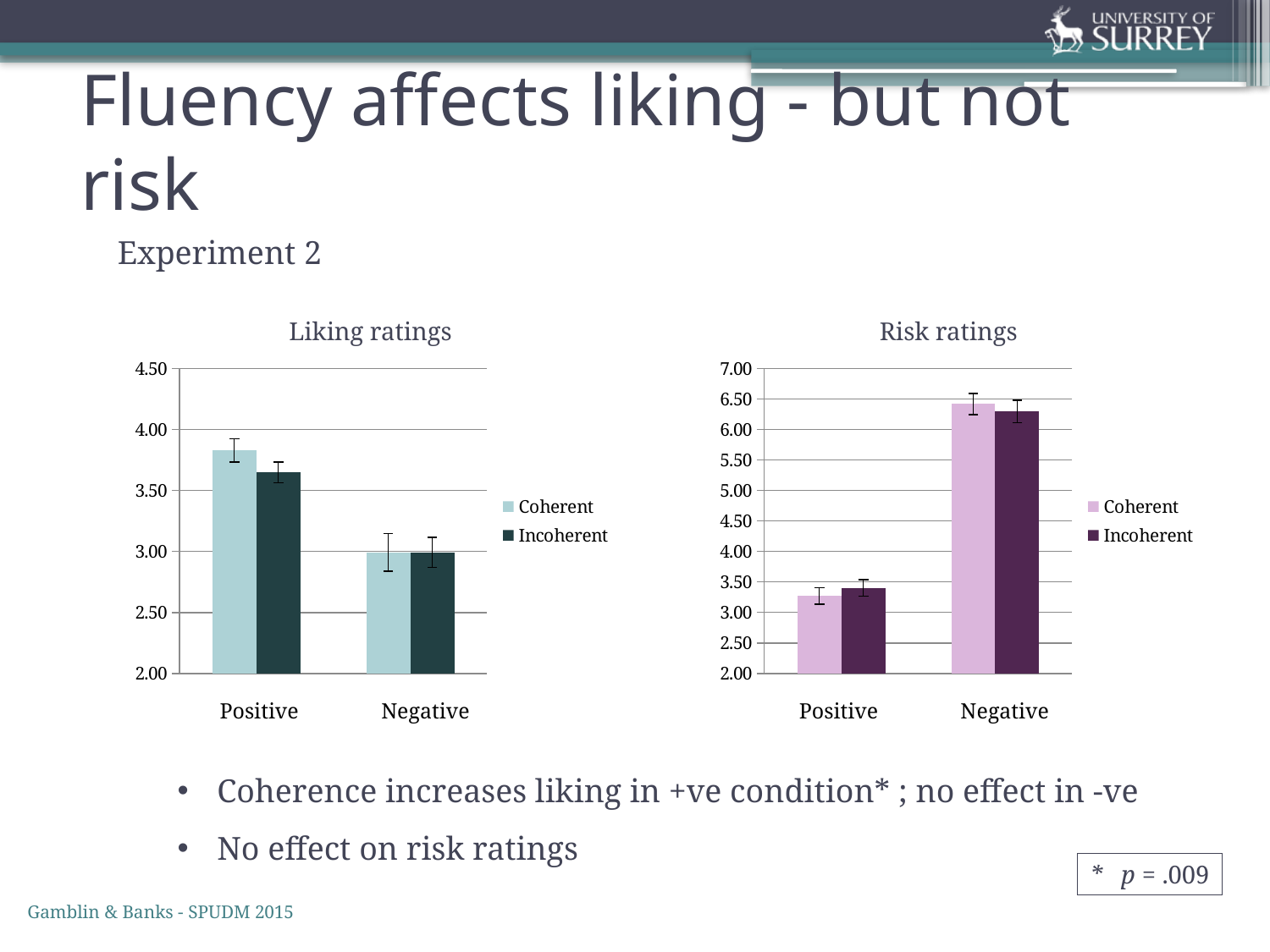
In the "Liking ratings" chart, which category has the lowest Coherent value? Negative In the "Liking ratings" chart, which is larger for the Positive category: Coherent or Incoherent? Coherent What are the two series named in the legend of the "Liking ratings" chart? Coherent and Incoherent What kind of chart is the "Liking ratings" chart? bar chart In the "Liking ratings" chart, is the Incoherent value for Negative greater or less than 3.50? less In the "Risk ratings" chart, which category has the highest Coherent value? Negative How many series does the legend of the "Risk ratings" chart list? 2 In the "Liking ratings" chart, is the Coherent value for Positive greater or less than 3.50? greater What is the title of the chart on the right side of the slide? Risk ratings In the "Risk ratings" chart, is the Incoherent value for Positive greater or less than 4.00? less How many categories are shown on the x axis of the "Liking ratings" chart? 2